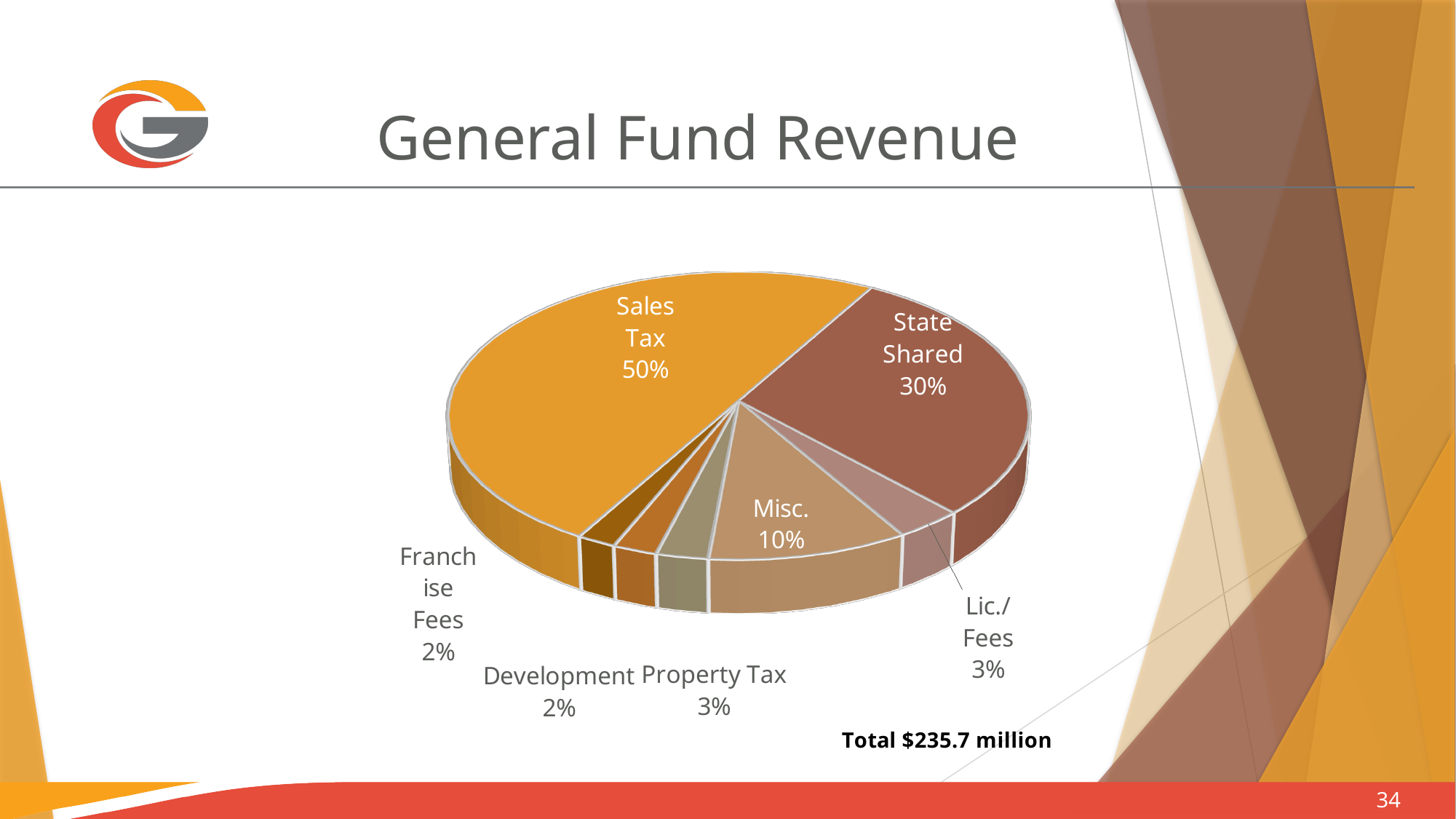
What total amount of General Fund Revenue is stated on the slide? $235.7 million Which is larger, the Misc. share or the Lic./Fees share? Misc. What is the difference in percentage points between Sales Tax and State Shared? 20 What percentage of the pie is Misc.? 10% What share of General Fund Revenue comes from State Shared? 30% What percentage of the pie is Development? 2% What share of General Fund Revenue comes from Sales Tax? 50% What percentage of the pie is Property Tax? 3% What kind of chart is shown on the slide? pie chart How many slices does the pie chart have? 7 What percentage of the pie is Lic./Fees? 3% Which category has the largest share of General Fund Revenue? Sales Tax